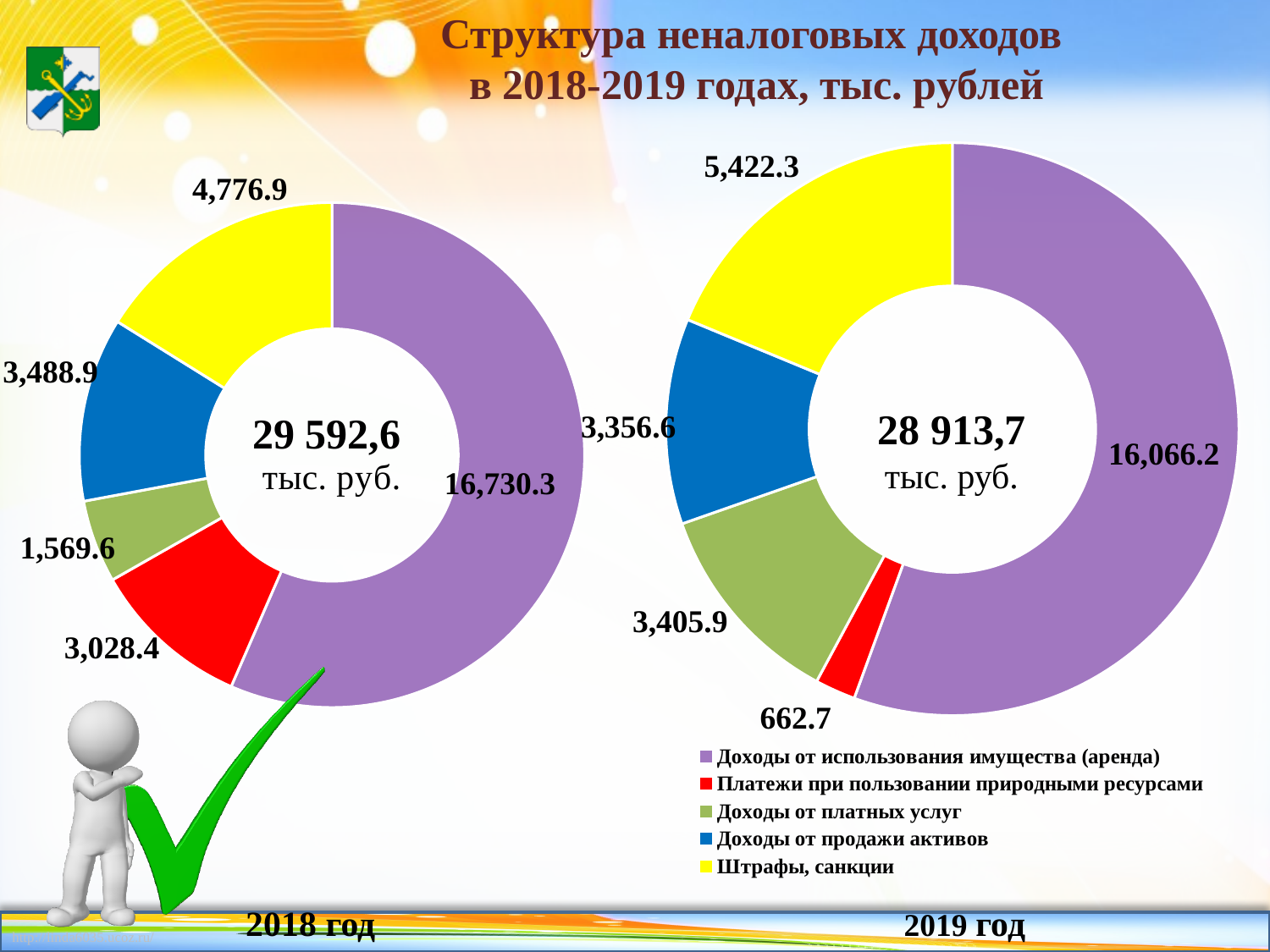
Which colour represents Доходы от продажи активов in the legend? Blue Which is larger: Доходы от платных услуг in 2018 or in 2019? 2019 What type of chart is used for the 2018 and 2019 data? Pie (doughnut) chart On the 2018 chart, which category has the smallest value? Доходы от платных услуг How many categories does the legend list? 5 On the 2019 chart, which category has the largest value? Доходы от использования имущества (аренда) On the 2018 chart, what is the difference between Штрафы, санкции and Доходы от продажи активов? 1,288.0 On the 2019 chart, what is the value for Штрафы, санкции? 5,422.3 On the 2018 chart, what is the value for Доходы от использования имущества (аренда)? 16,730.3 On the 2019 chart, what is the value for Платежи при пользовании природными ресурсами? 662.7 On the 2018 chart, what is the value for Доходы от платных услуг? 1,569.6 What total is shown in the centre of the 2019 chart? 28 913,7 тыс. руб.